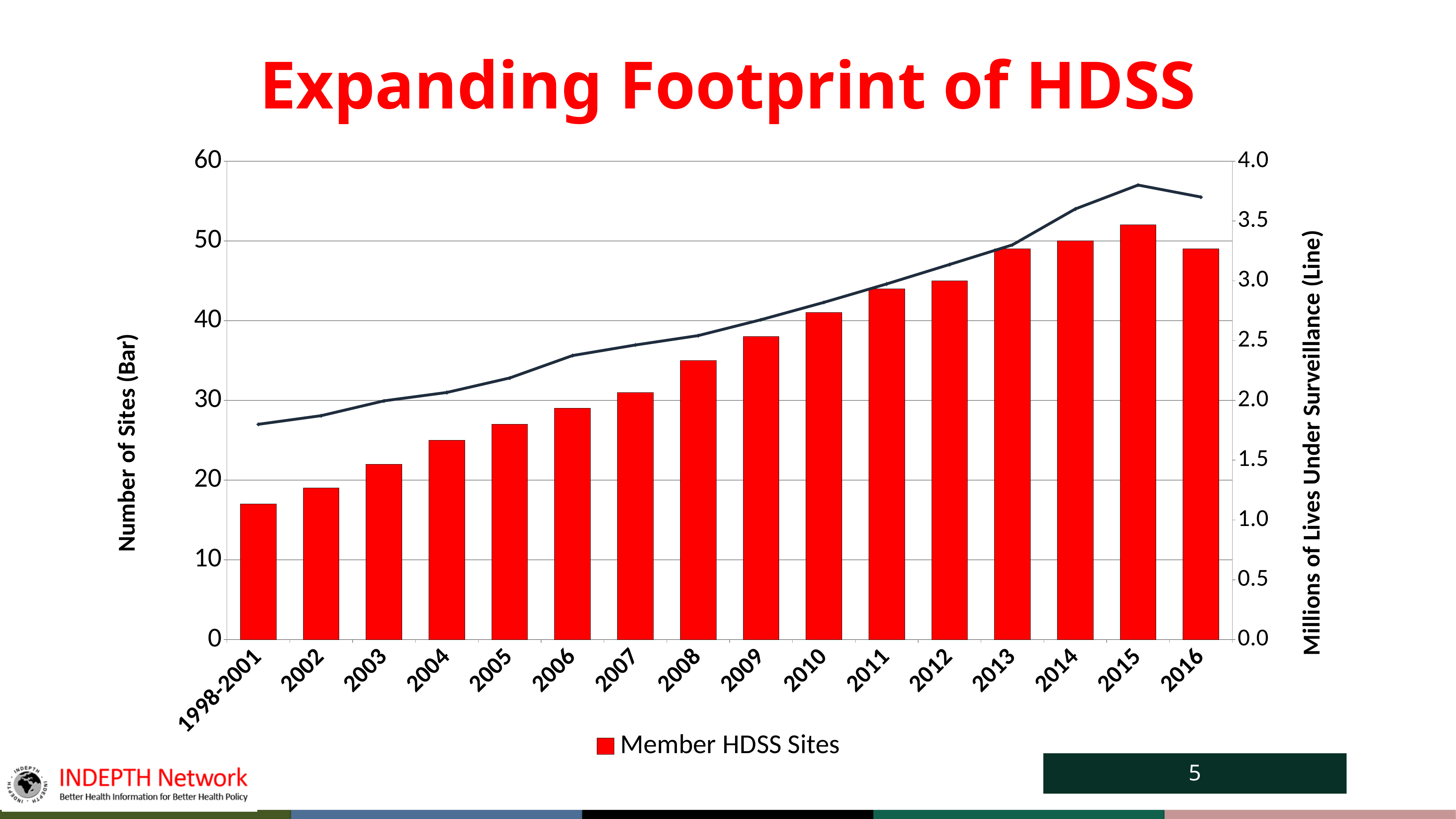
What is the title of the left vertical axis? Number of Sites (Bar) Which category has the shortest bar for Member HDSS Sites? 1998-2001 What kind of chart is shown on the slide? bar chart with a line How many year categories are shown on the x axis? 16 Which year has the tallest bar for Member HDSS Sites? 2015 Is the number of Member HDSS Sites in 2012 greater or less than 50? less Is the line value (Millions of Lives Under Surveillance) for 1998-2001 greater or less than 2.0? less Is the number of Member HDSS Sites in 2008 greater or less than 30? greater Which year has a taller bar for Member HDSS Sites, 2015 or 2016? 2015 Do the Member HDSS Sites bars generally rise or fall from 1998-2001 to 2015? rise